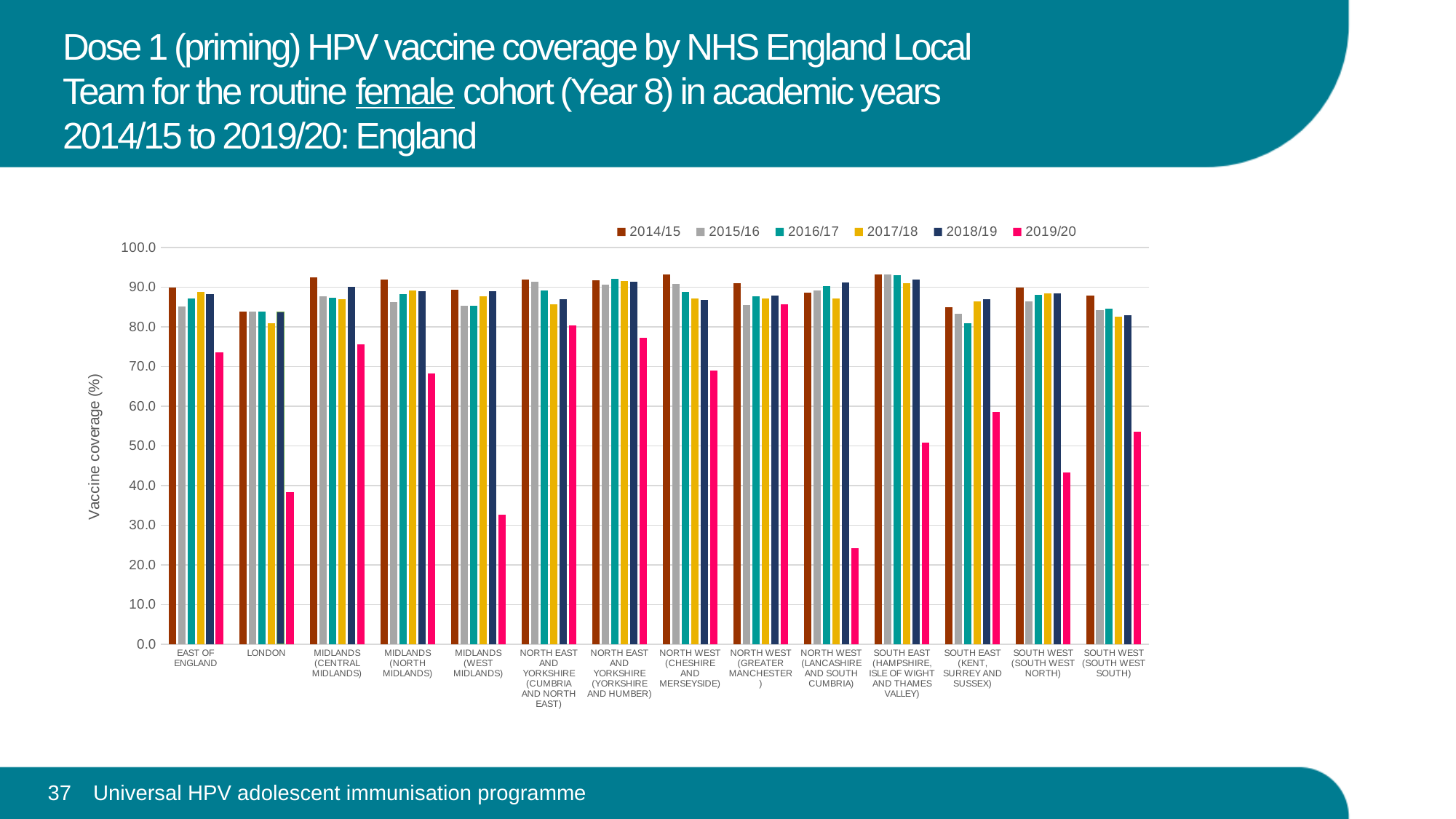
For MIDLANDS (WEST MIDLANDS), is the 2019/20 value larger or smaller than the 2018/19 value? smaller Is the 2014/15 value for EAST OF ENGLAND greater or less than 80? greater What kind of chart is shown on the slide? Bar chart Which local team has the lowest 2019/20 value? NORTH WEST (LANCASHIRE AND SOUTH CUMBRIA) Which local team has the highest 2019/20 value? NORTH WEST (GREATER MANCHESTER) Is the 2019/20 value for NORTH WEST (LANCASHIRE AND SOUTH CUMBRIA) greater or less than 30? less What is the label on the y axis? Vaccine coverage (%) Which has the larger 2019/20 value, EAST OF ENGLAND or LONDON? EAST OF ENGLAND Is the 2019/20 value for LONDON greater or less than 50? less How many NHS England Local Teams are shown on the x axis? 14 How many series does the legend list? 6